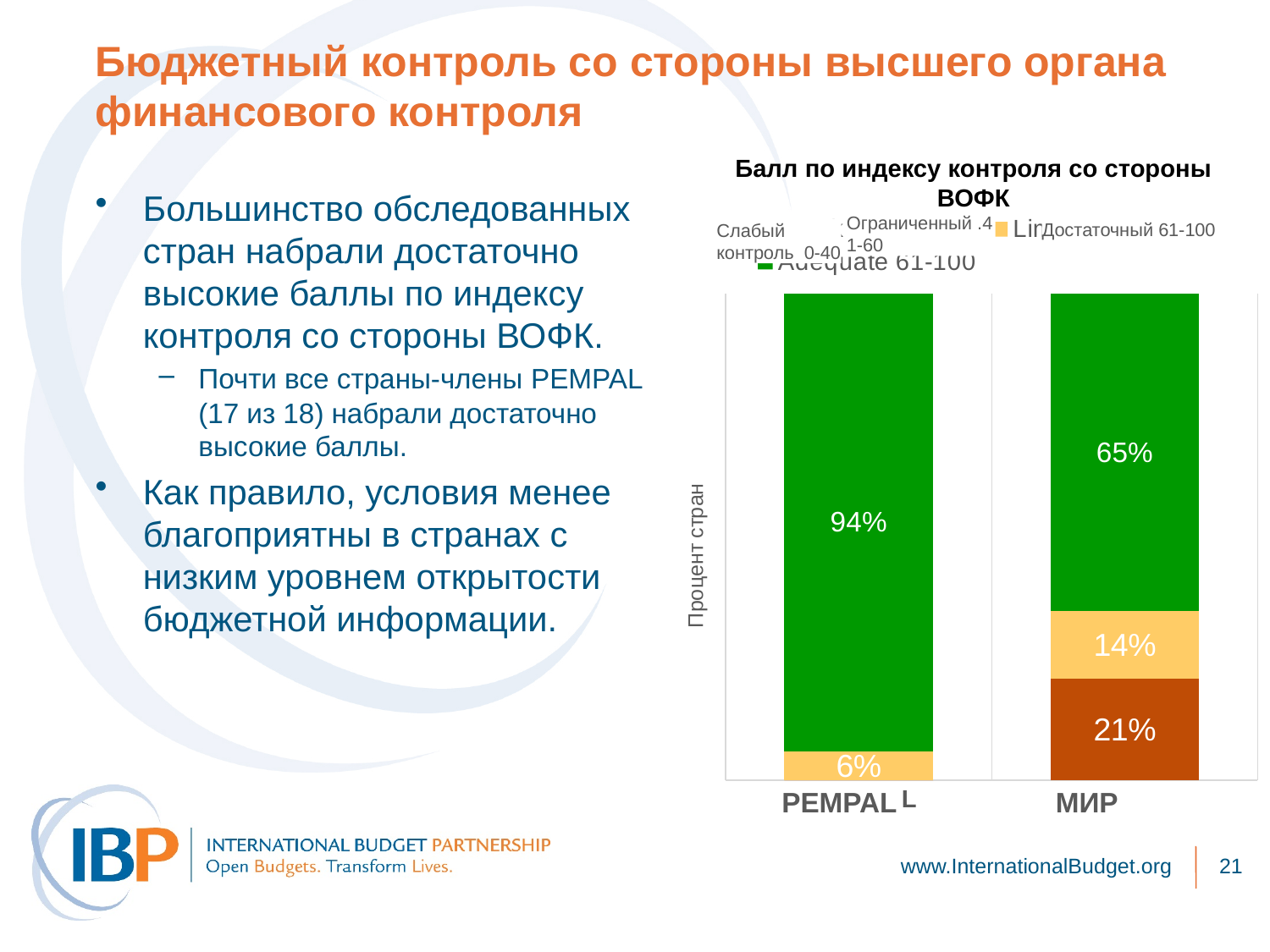
What is the value of the yellow (bottom) segment of the PEMPAL bar? 6% What is the total of the labelled segments in the МИР bar? 100% What type of chart is shown on the slide? Stacked bar chart Which bar has the larger green 'Достаточный 61-100' segment, PEMPAL or МИР? PEMPAL By how many percentage points does the green segment of PEMPAL exceed the green segment of МИР? 29 percentage points What is the difference between the brown and yellow segments of the МИР bar? 7 percentage points How many categories (bars) are shown on the x axis of the chart? 2 What is the value of the yellow (middle) segment of the МИР bar? 14% What percentage of PEMPAL countries falls in the green 'Достаточный 61-100' segment? 94% What is the value of the brown (bottom) segment of the МИР bar? 21% What is the label of the vertical axis of the chart? Процент стран What percentage of countries in the МИР bar falls in the green 'Достаточный 61-100' segment? 65%